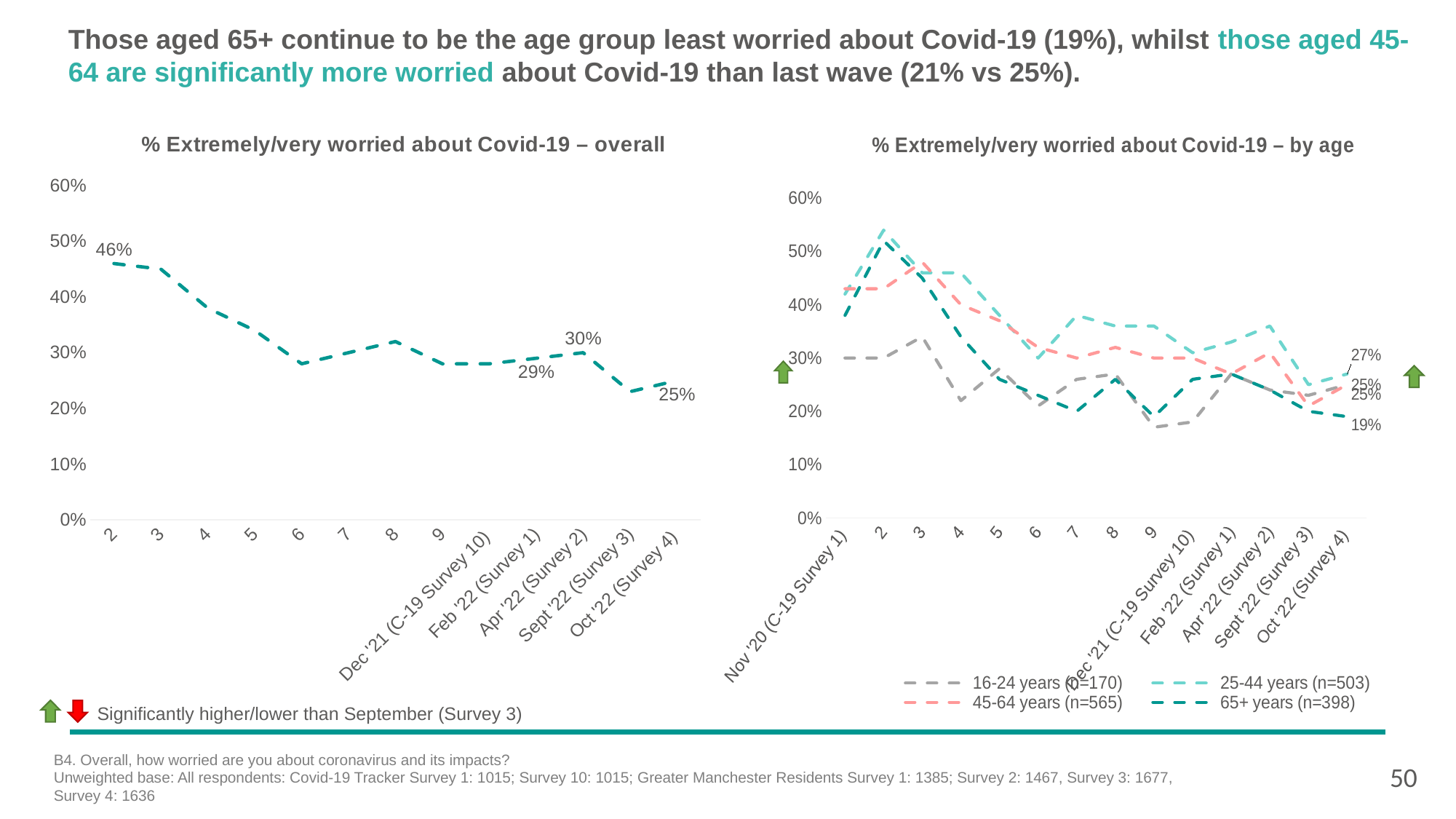
In the left chart ('overall'), do the values generally rise or fall from left to right along the x axis? Fall In the left chart ('overall'), what is the difference between the value at point '2' (46%) and the value at Oct '22 (Survey 4) (25%)? 21 percentage points In the left chart ('overall'), what is the value at the first point, labelled '2'? 46% How many data points are plotted in the left chart ('overall')? 13 In the left chart ('overall'), what is the value for Apr '22 (Survey 2)? 30% In the right chart ('by age'), is the value for 65+ years at Nov '20 (C-19 Survey 1) greater or less than 30%? greater In the right chart ('by age'), which age group has the lowest value at Oct '22 (Survey 4)? 65+ years In the left chart ('overall'), what is the value for Oct '22 (Survey 4)? 25% In the left chart ('overall'), what is the value for Feb '22 (Survey 1)? 29% In the right chart ('by age'), what is the value for 65+ years at Oct '22 (Survey 4)? 19% What kind of chart is the left chart, '% Extremely/very worried about Covid-19 – overall'? Line chart How many series does the legend of the right chart ('by age') list? 4